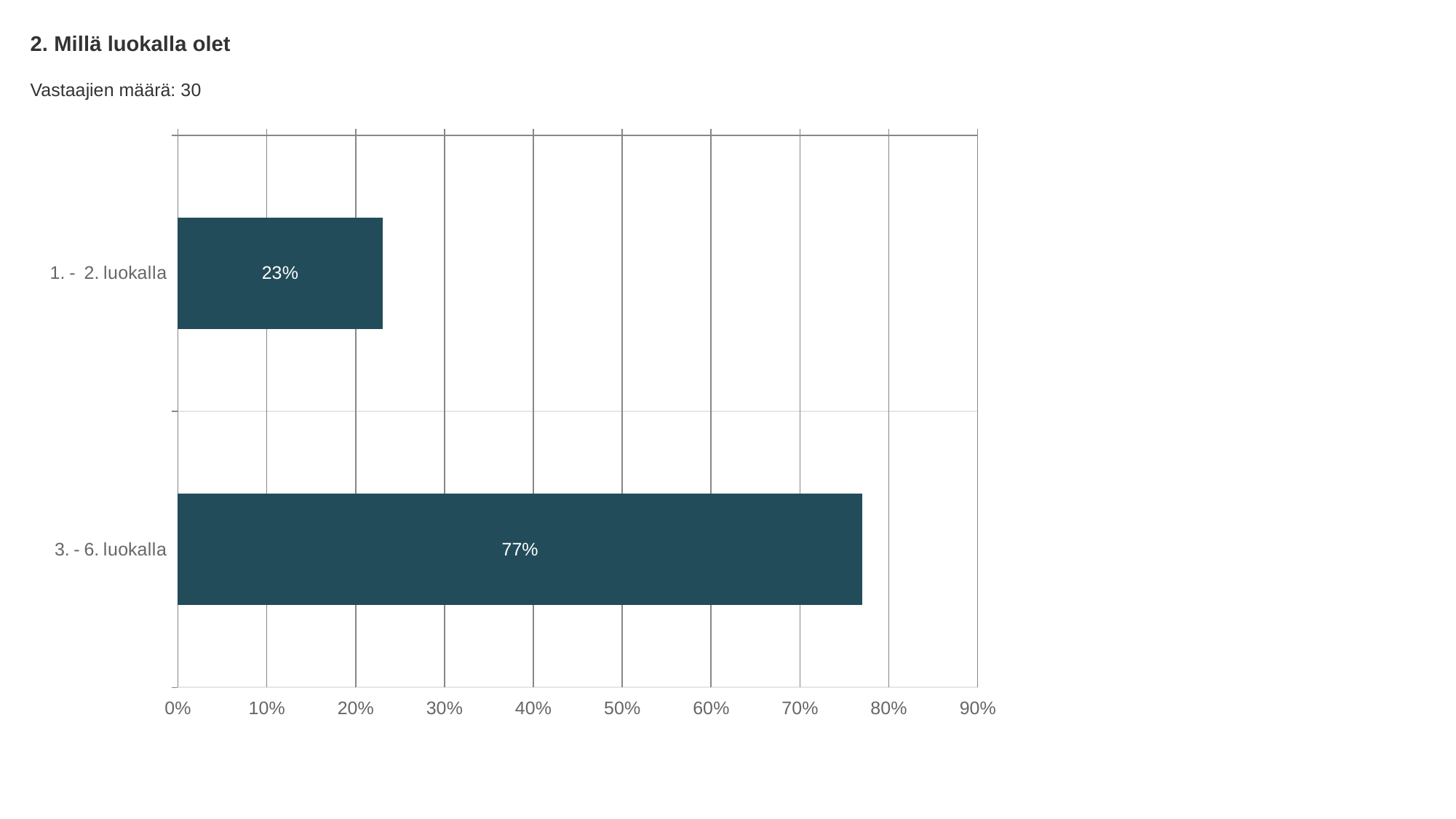
Which is larger, the value for "1. - 2. luokalla" or the value for "3. - 6. luokalla"? 3. - 6. luokalla What is the difference between the values for "3. - 6. luokalla" and "1. - 2. luokalla"? 54% What is the value for "3. - 6. luokalla"? 77% What kind of chart is shown on the slide? Bar chart Is the value for "3. - 6. luokalla" greater or less than 70%? greater What is the title of the chart? 2. Millä luokalla olet What is the value for "1. - 2. luokalla"? 23% Is the value for "1. - 2. luokalla" greater or less than 30%? less Which category has the highest value? 3. - 6. luokalla How many categories are shown in the chart? 2 How many respondents (Vastaajien määrä) does the slide report? 30 Which category has the lowest value? 1. - 2. luokalla